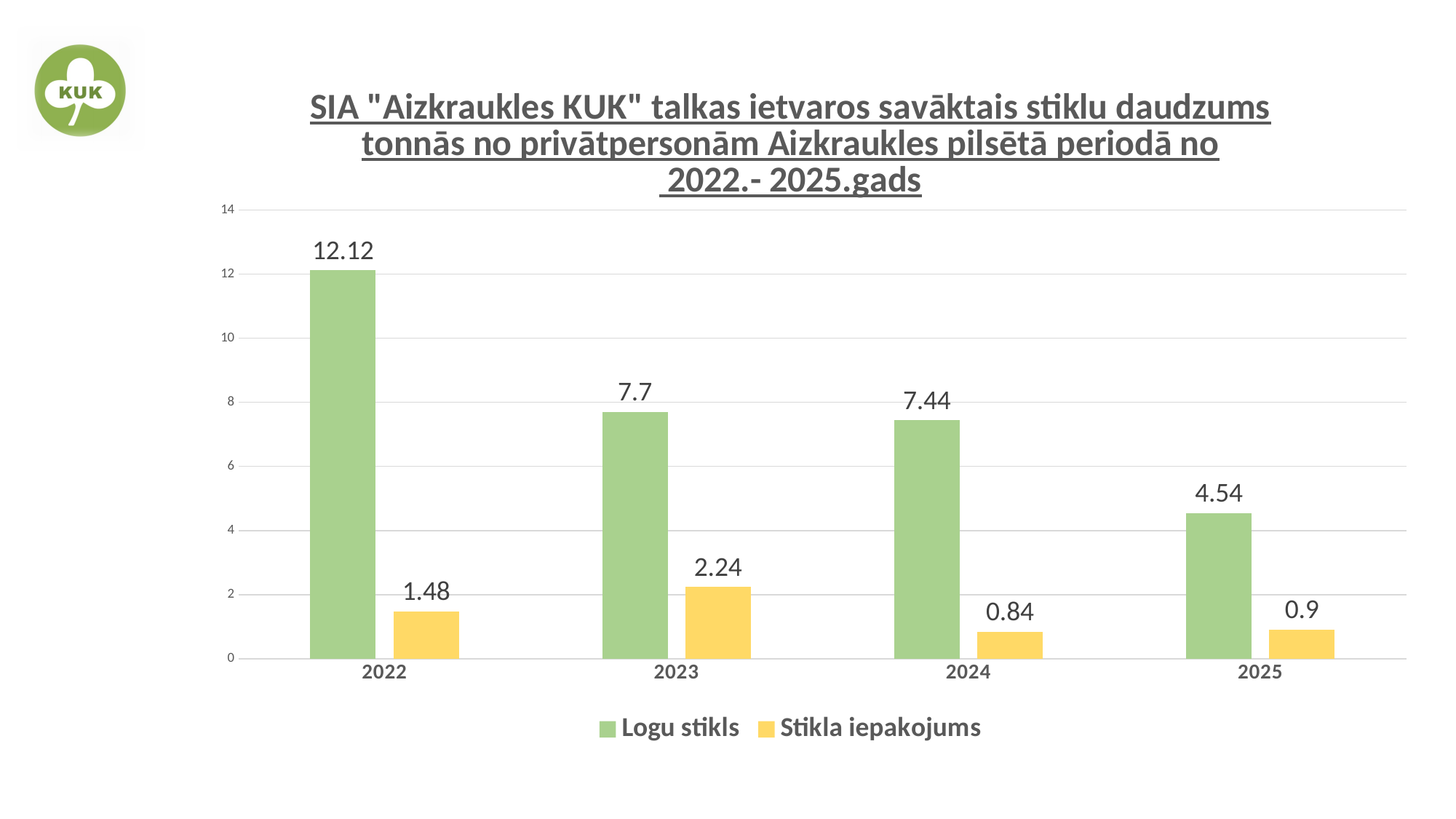
In which year is the Logu stikls value highest? 2022 What kind of chart is shown on the slide? Bar chart How many years are shown on the x axis? 4 Which is larger: Stikla iepakojums in 2022 or Stikla iepakojums in 2025? Stikla iepakojums in 2022 What is the value for Logu stikls in 2022? 12.12 What is the value for Stikla iepakojums in 2023? 2.24 What is the value for Stikla iepakojums in 2024? 0.84 Does the Logu stikls value rise or fall from 2022 to 2025? Fall What is the value for Logu stikls in 2025? 4.54 In which year is the Stikla iepakojums value lowest? 2024 How many series does the legend list? 2 What is the difference between the Logu stikls values for 2022 and 2023? 4.42